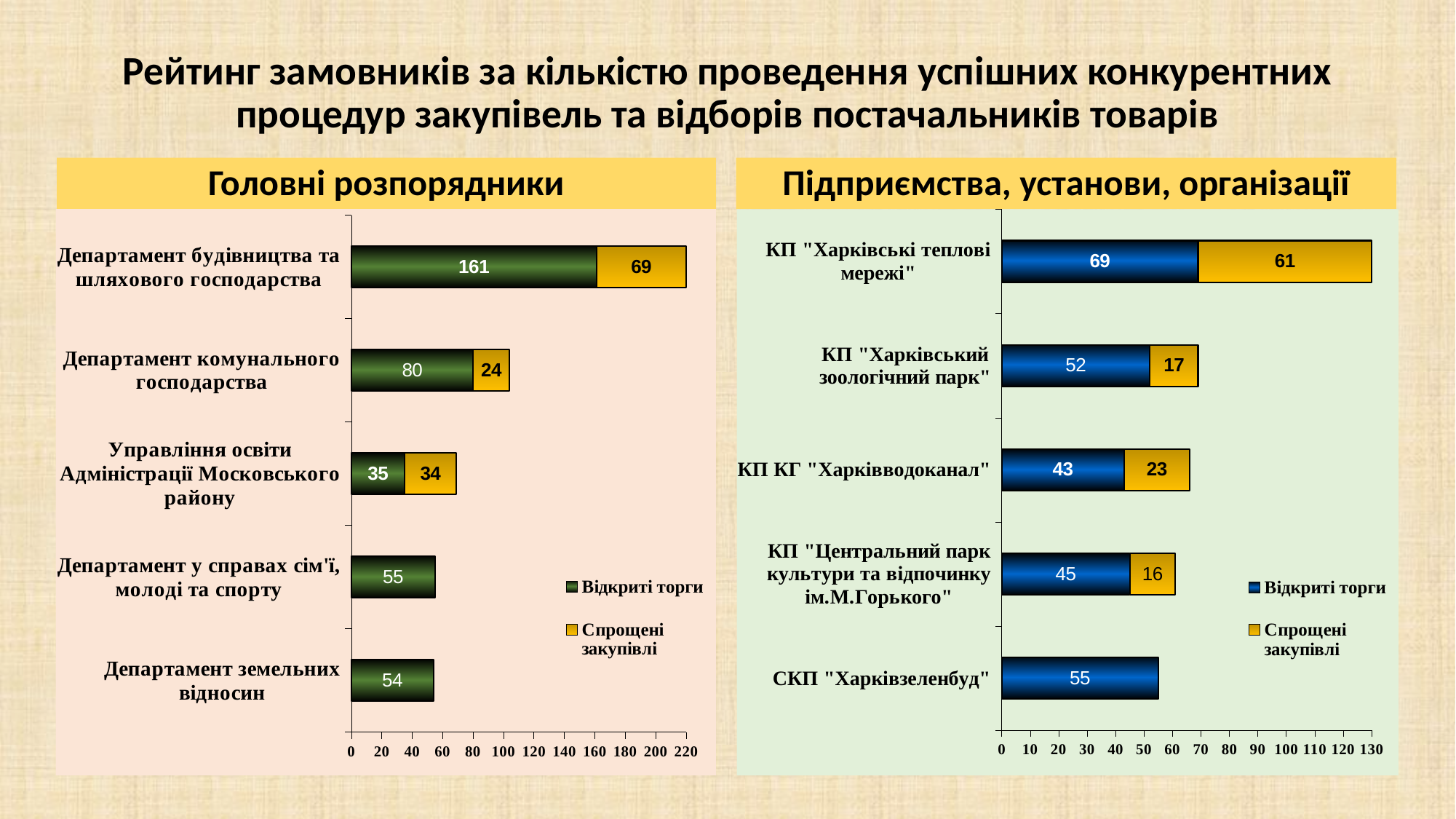
In the chart "Головні розпорядники", what is the difference between Відкриті торги and Спрощені закупівлі for Департамент будівництва та шляхового господарства? 92 In the chart "Головні розпорядники", how many categories are shown? 5 In the chart "Підприємства, установи, організації", which is larger: Відкриті торги for КП "Харківський зоологічний парк" or Відкриті торги for КП КГ "Харківводоканал"? КП "Харківський зоологічний парк" In the chart "Підприємства, установи, організації", what is the total of the stacked bar for КП КГ "Харківводоканал"? 66 In the chart "Головні розпорядники", what is the value of Спрощені закупівлі for Управління освіти Адміністрації Московського району? 34 In the chart "Підприємства, установи, організації", what is the value of Спрощені закупівлі for КП "Харківські теплові мережі"? 61 In the chart "Підприємства, установи, організації", what is the value of Відкриті торги for СКП "Харківзеленбуд"? 55 In the chart "Головні розпорядники", what is the value of Відкриті торги for Департамент будівництва та шляхового господарства? 161 In the chart "Головні розпорядники", what is the total of the stacked bar for Департамент комунального господарства? 104 In the chart "Головні розпорядники", which category has the highest value of Відкриті торги? Департамент будівництва та шляхового господарства In the chart "Підприємства, установи, організації", which category has the lowest value of Спрощені закупівлі among those with a Спрощені закупівлі bar? КП "Центральний парк культури та відпочинку ім.М.Горького" How many series does the legend of the chart "Підприємства, установи, організації" list? 2